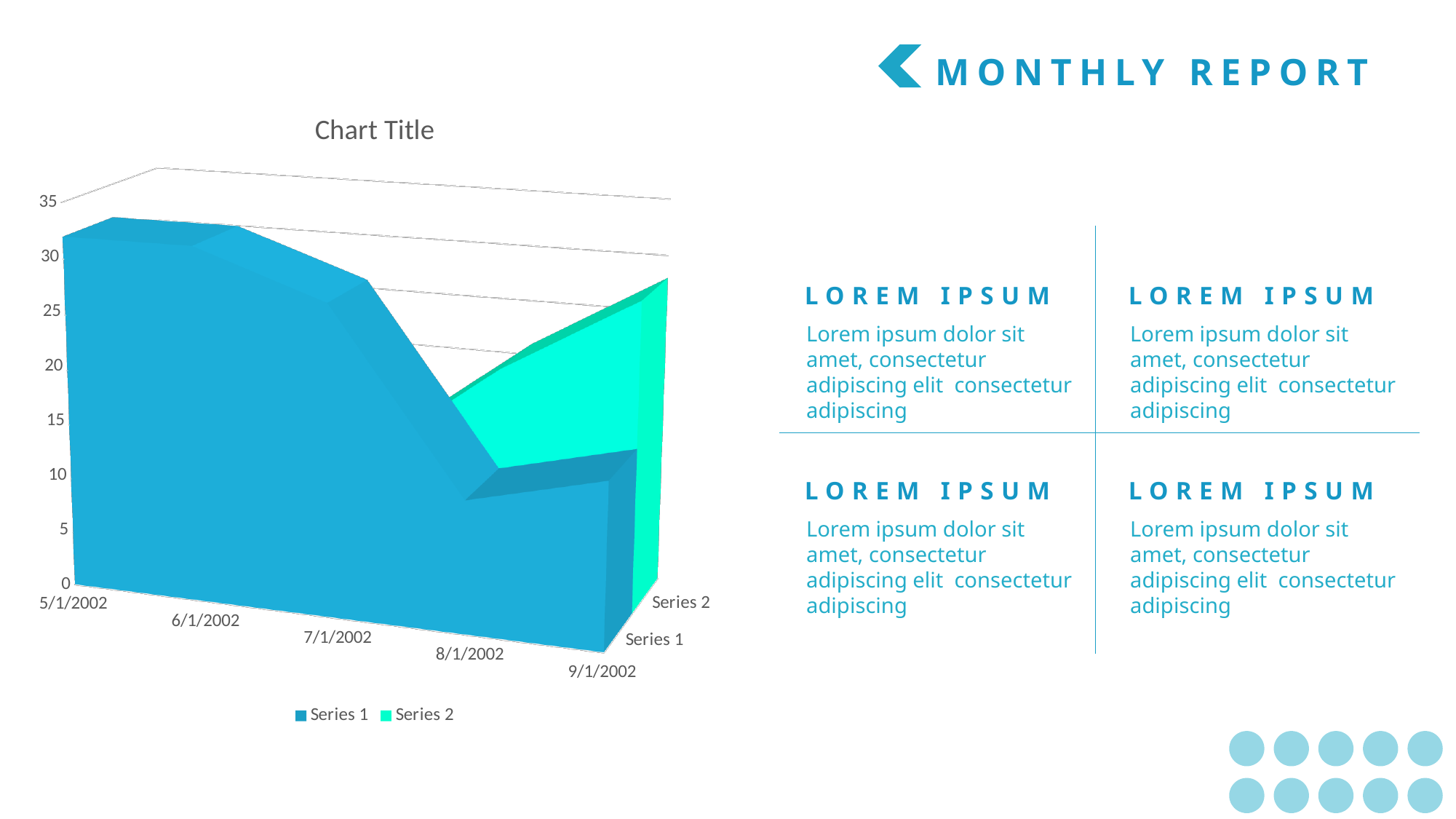
What is the title of the chart? Chart Title For Series 1, which is larger: the value at 5/1/2002 or the value at 8/1/2002? 5/1/2002 How many dates are shown along the x axis of the chart? 5 Do the values for Series 1 generally rise or fall from 5/1/2002 to 9/1/2002? fall For Series 1, which is larger: the value at 7/1/2002 or the value at 9/1/2002? 7/1/2002 What kind of chart is shown on the slide? area chart Which colour represents Series 2 in the chart legend? green Is the value for Series 1 at 8/1/2002 greater or less than 20? less For Series 2, which is larger: the value at 8/1/2002 or the value at 9/1/2002? 9/1/2002 Is the value for Series 1 at 7/1/2002 greater or less than 20? greater How many series does the chart legend list? 2 Is the value for Series 1 at 5/1/2002 greater or less than 25? greater